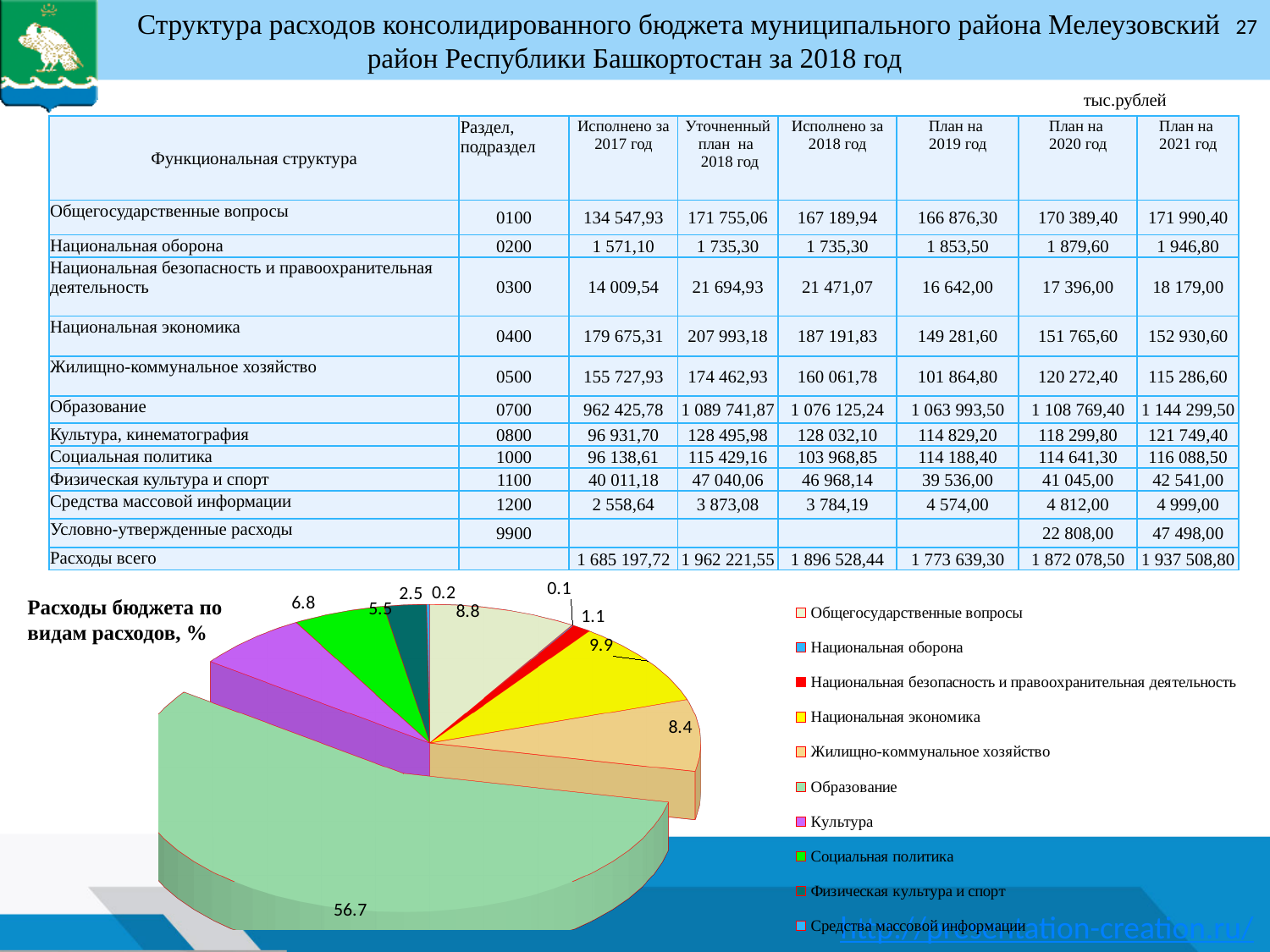
In the pie chart, which is larger: the share for Культура or for Социальная политика? Культура In the pie chart, what share is shown for Национальная экономика? 9.9 Which category has the smallest slice in the pie chart? Национальная оборона In the pie chart, what share is shown for Жилищно-коммунальное хозяйство? 8.4 In the pie chart, what share is shown for Образование? 56.7 In the pie chart, how much larger is the share for Национальная экономика than for Общегосударственные вопросы? 1.1 Which category has the largest slice in the pie chart? Образование In the pie chart, what share is shown for Физическая культура и спорт? 2.5 In the pie chart, what share is shown for Культура? 6.8 What is the title of the pie chart? Расходы бюджета по видам расходов, % What kind of chart is shown at the bottom of the slide? pie chart How many categories does the legend of the pie chart list? 10